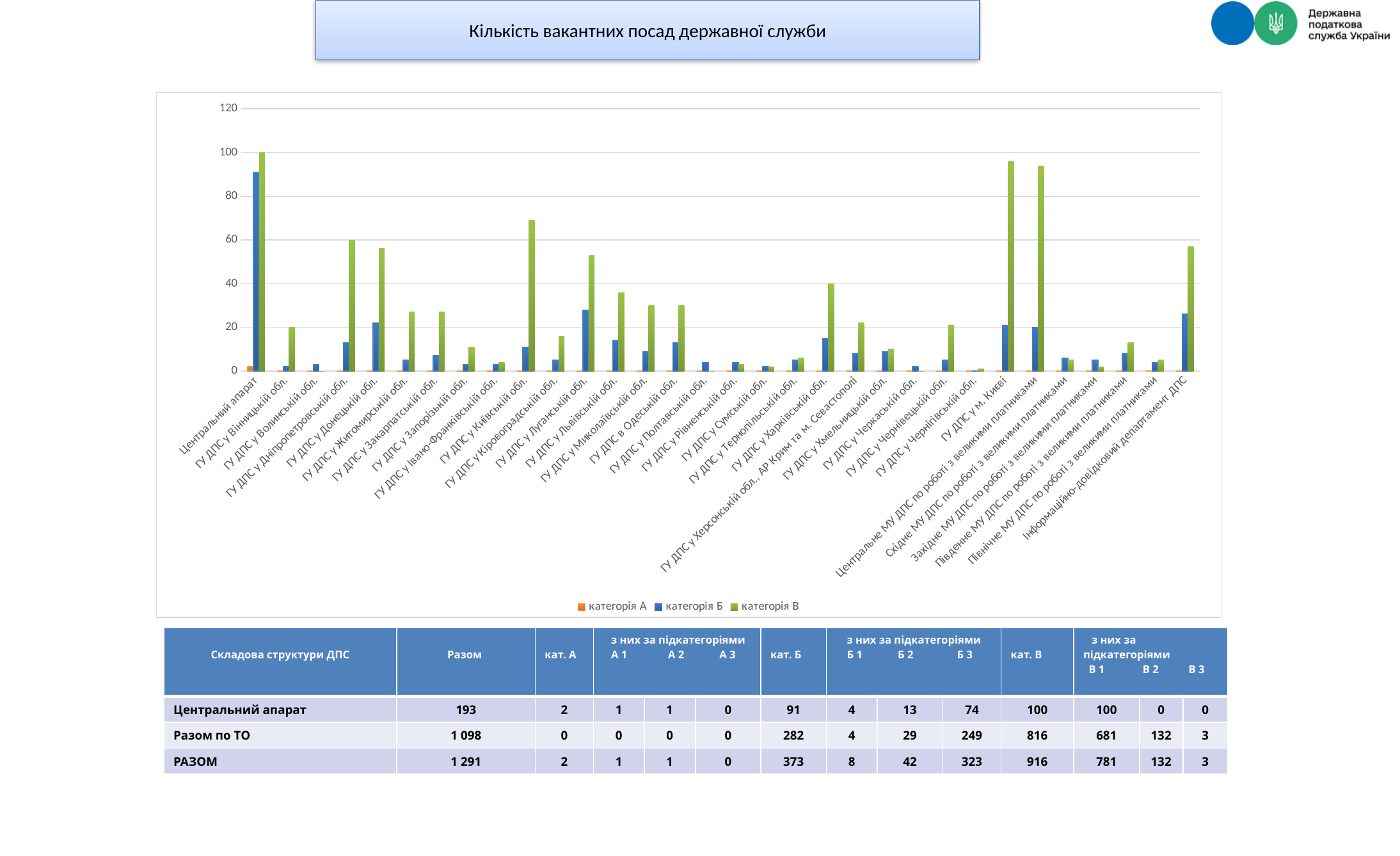
What kind of chart is shown on the slide? bar chart Is the value of категорія В for Центральне МУ ДПС по роботі з великими платниками greater or less than 80? greater Is the value of категорія В for ГУ ДПС у Київській обл. greater or less than 60? greater What is the value of категорія В for Центральний апарат? 100 Which is larger for категорія Б: Центральний апарат or ГУ ДПС у Львівській обл.? Центральний апарат Which category has the highest value for категорія Б? Центральний апарат Is the value of категорія В for Інформаційно-довідковий департамент ДПС greater or less than 40? greater What is the title shown above the chart? Кількість вакантних посад державної служби Which is larger for категорія В: ГУ ДПС у Київській обл. or ГУ ДПС у Луганській обл.? ГУ ДПС у Київській обл. What are the three series named in the chart legend? категорія А, категорія Б, категорія В How many categories are shown along the x axis of the chart? 32 How many series does the chart legend list? 3